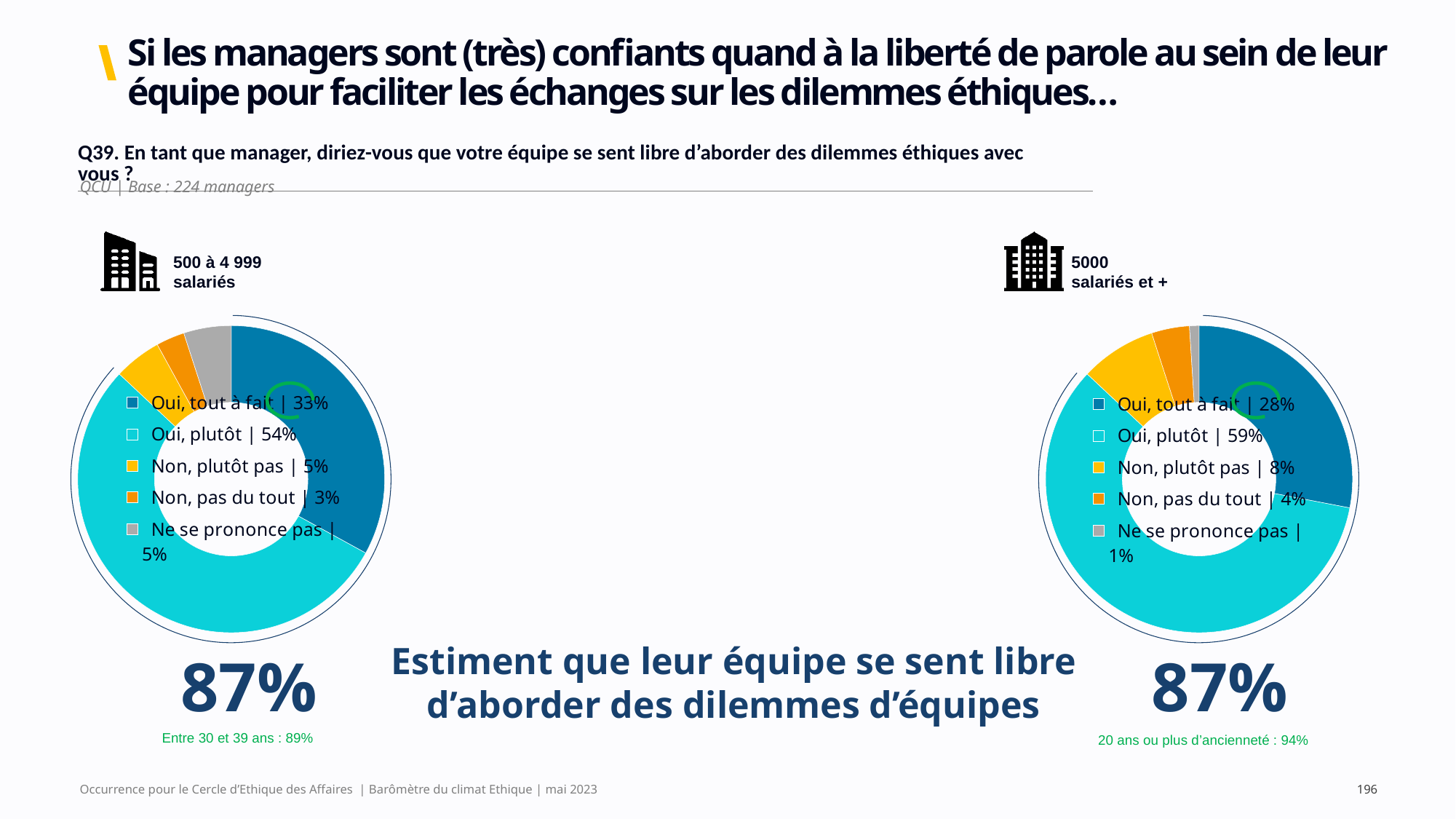
In the chart for 5000 salariés et +, what percentage answered "Non, plutôt pas"? 8% How many categories does the legend of the 500 à 4 999 salariés chart list? 5 In the chart for 5000 salariés et +, what colour represents "Non, pas du tout"? Orange Which chart has the larger share for "Oui, tout à fait": 500 à 4 999 salariés or 5000 salariés et +? 500 à 4 999 salariés In the chart for 500 à 4 999 salariés, what percentage answered "Non, pas du tout"? 3% In the chart for 500 à 4 999 salariés, which category has the largest share? Oui, plutôt What is the difference between the "Oui, plutôt" shares in the 5000 salariés et + chart and the 500 à 4 999 salariés chart? 5% In the chart for 5000 salariés et +, what percentage answered "Oui, tout à fait"? 28% In the chart for 5000 salariés et +, which category has the smallest share? Ne se prononce pas In the chart for 500 à 4 999 salariés, what is the combined share of "Oui, tout à fait" and "Oui, plutôt"? 87% In the chart for 500 à 4 999 salariés, what percentage answered "Oui, plutôt"? 54% What kind of chart is used for the 5000 salariés et + data? Donut (pie) chart